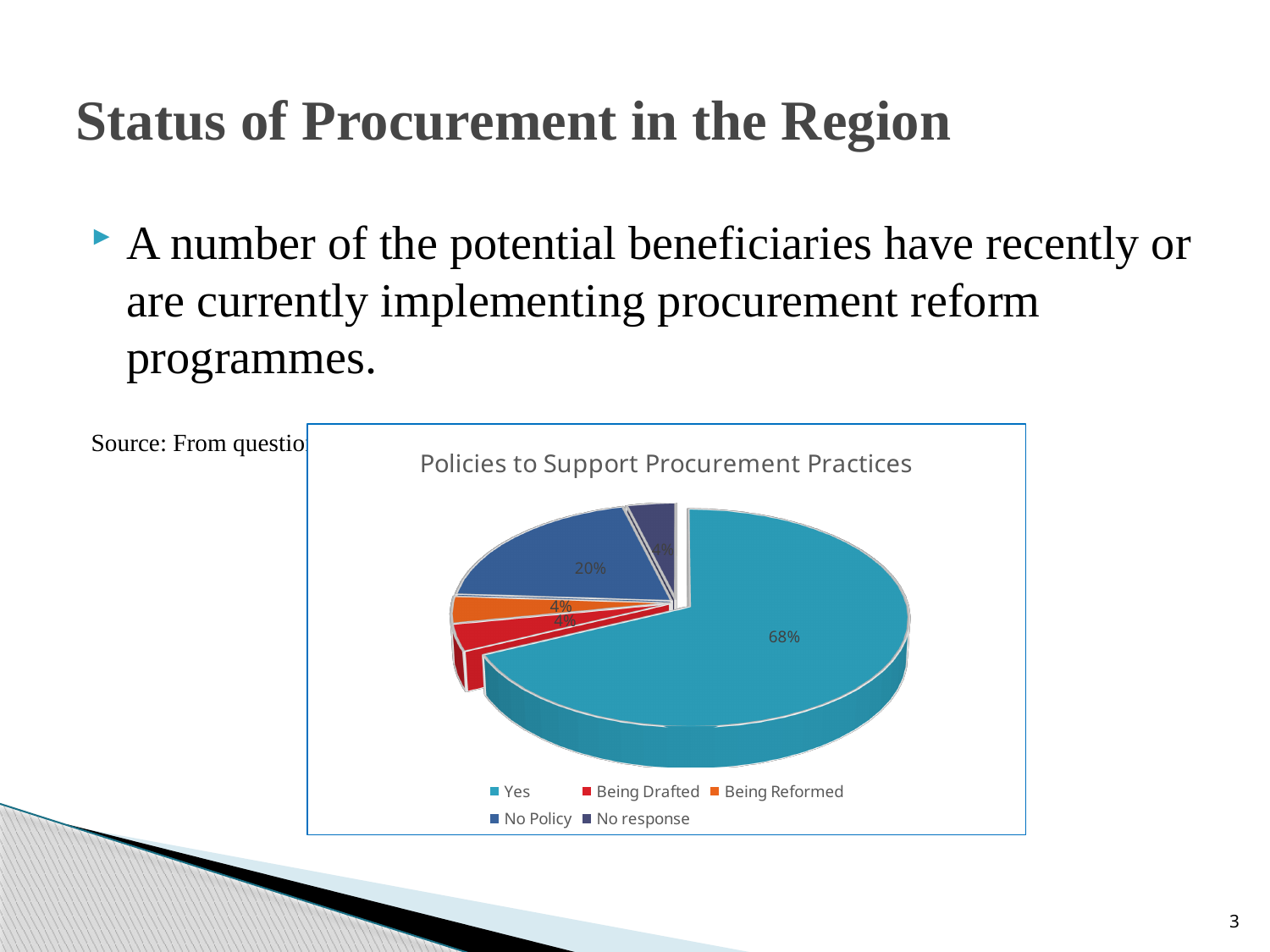
What share of the pie is labelled for the 'No Policy' category? 20% Which category has the largest slice of the pie? Yes What is the combined share of the 'Yes' and 'No Policy' slices? 88% What is the difference in percentage points between the 'Yes' share and the 'No Policy' share? 48 How many categories does the legend of the pie chart list? 5 What share of the pie is labelled for the 'Being Reformed' category? 4% What type of chart is shown on the slide? pie chart What share of the pie is labelled for the 'Yes' category? 68% What share of the pie is labelled for the 'Being Drafted' category? 4% What is the title of the chart? Policies to Support Procurement Practices Which legend entry is shown in red? Being Drafted Which is larger, the share for 'No Policy' or the share for 'Being Drafted'? No Policy